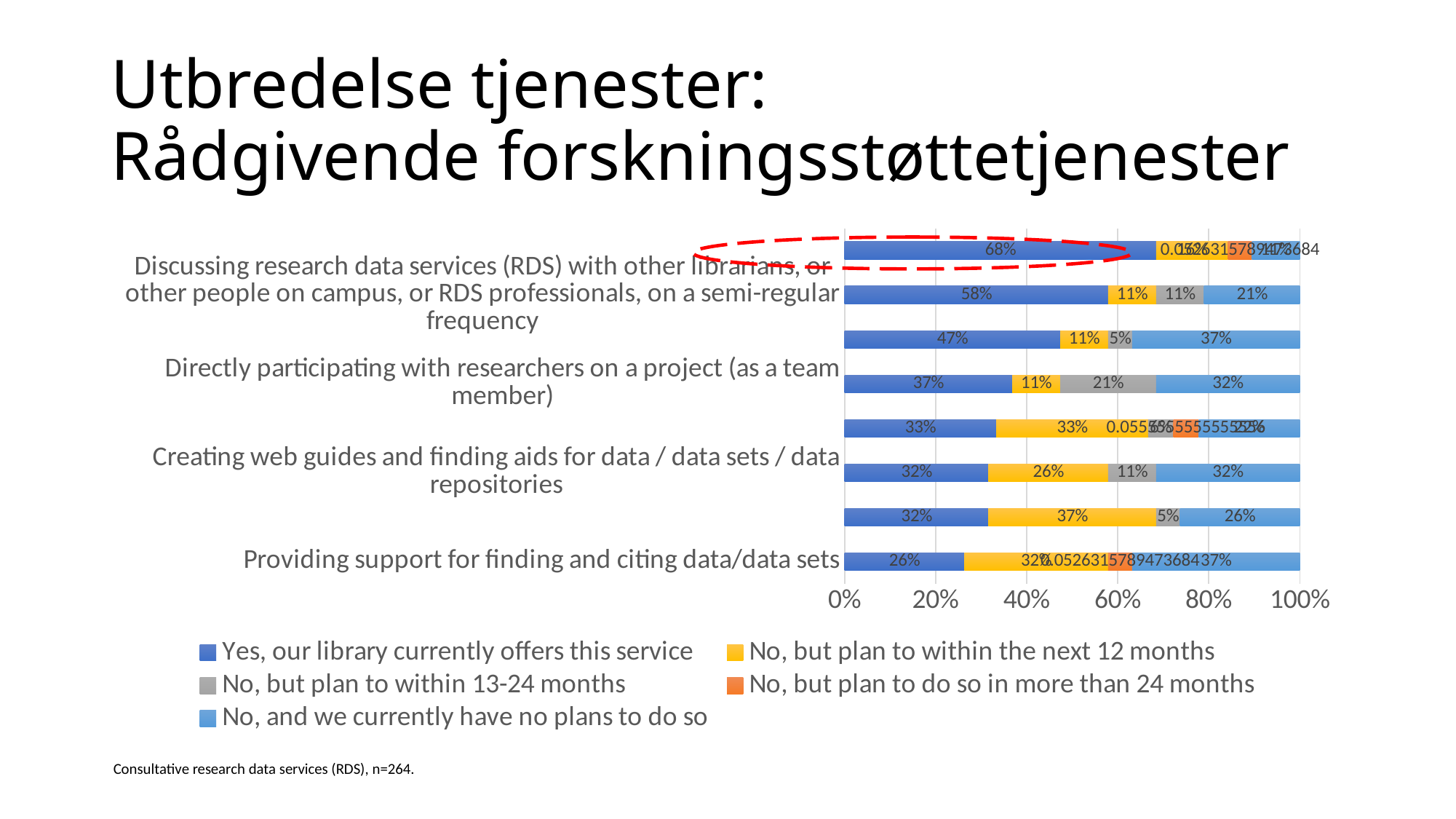
How many series does the chart legend list? 5 What is the value of 'Yes, our library currently offers this service' for 'Providing support for finding and citing data/data sets'? 26% What is the value of 'No, but plan to within 13-24 months' for 'Directly participating with researchers on a project (as a team member)'? 21% What is the value of 'No, but plan to within the next 12 months' for 'Creating web guides and finding aids for data / data sets / data repositories'? 26% What is the difference between the 'Yes, our library currently offers this service' values for 'Discussing research data services (RDS) with other librarians...' (58%) and 'Providing support for finding and citing data/data sets' (26%)? 32 percentage points What is the value of 'No, and we currently have no plans to do so' for 'Directly participating with researchers on a project (as a team member)'? 32% Which has a larger 'Yes, our library currently offers this service' value: 'Directly participating with researchers on a project (as a team member)' or 'Creating web guides and finding aids for data / data sets / data repositories'? Directly participating with researchers on a project (as a team member) What is the value of 'Yes, our library currently offers this service' for 'Discussing research data services (RDS) with other librarians, or other people on campus, or RDS professionals, on a semi-regular frequency'? 58% What type of chart is shown on the slide? Stacked bar chart How many bars are plotted in the chart? 8 Is the 'Yes, our library currently offers this service' value for 'Providing support for finding and citing data/data sets' greater or less than 40%? less What is the highest value shown for the series 'Yes, our library currently offers this service' across all bars? 68%